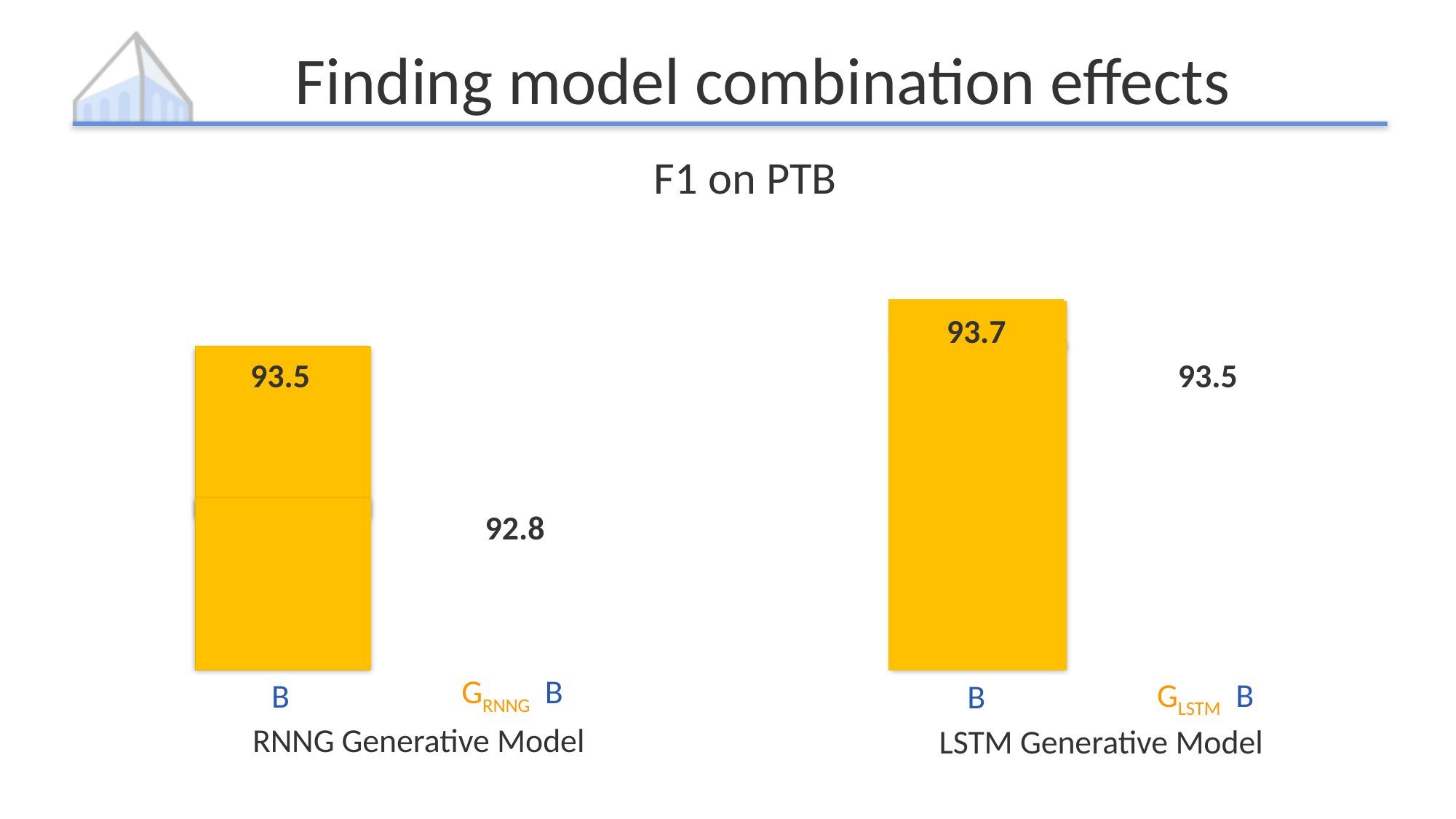
In the RNNG Generative Model chart, what is the difference between the F1 values for B and G_RNNG B? 0.7 Is the F1 value for B larger in the RNNG Generative Model chart or in the LSTM Generative Model chart? LSTM Generative Model In the RNNG Generative Model chart, what is the F1 value for G_RNNG B? 92.8 In the LSTM Generative Model chart, what is the difference between the F1 values for B and G_LSTM B? 0.2 What metric and dataset does the heading above the charts say the values are for? F1 on PTB In the LSTM Generative Model chart, what is the F1 value for B? 93.7 How many categories are shown in the LSTM Generative Model chart? 2 In the RNNG Generative Model chart, what is the F1 value for B? 93.5 What kind of chart is used on this slide? Bar chart In the RNNG Generative Model chart, which category has the higher F1 value? B In the LSTM Generative Model chart, which category has the lower F1 value? G_LSTM B In the LSTM Generative Model chart, what is the F1 value for G_LSTM B? 93.5